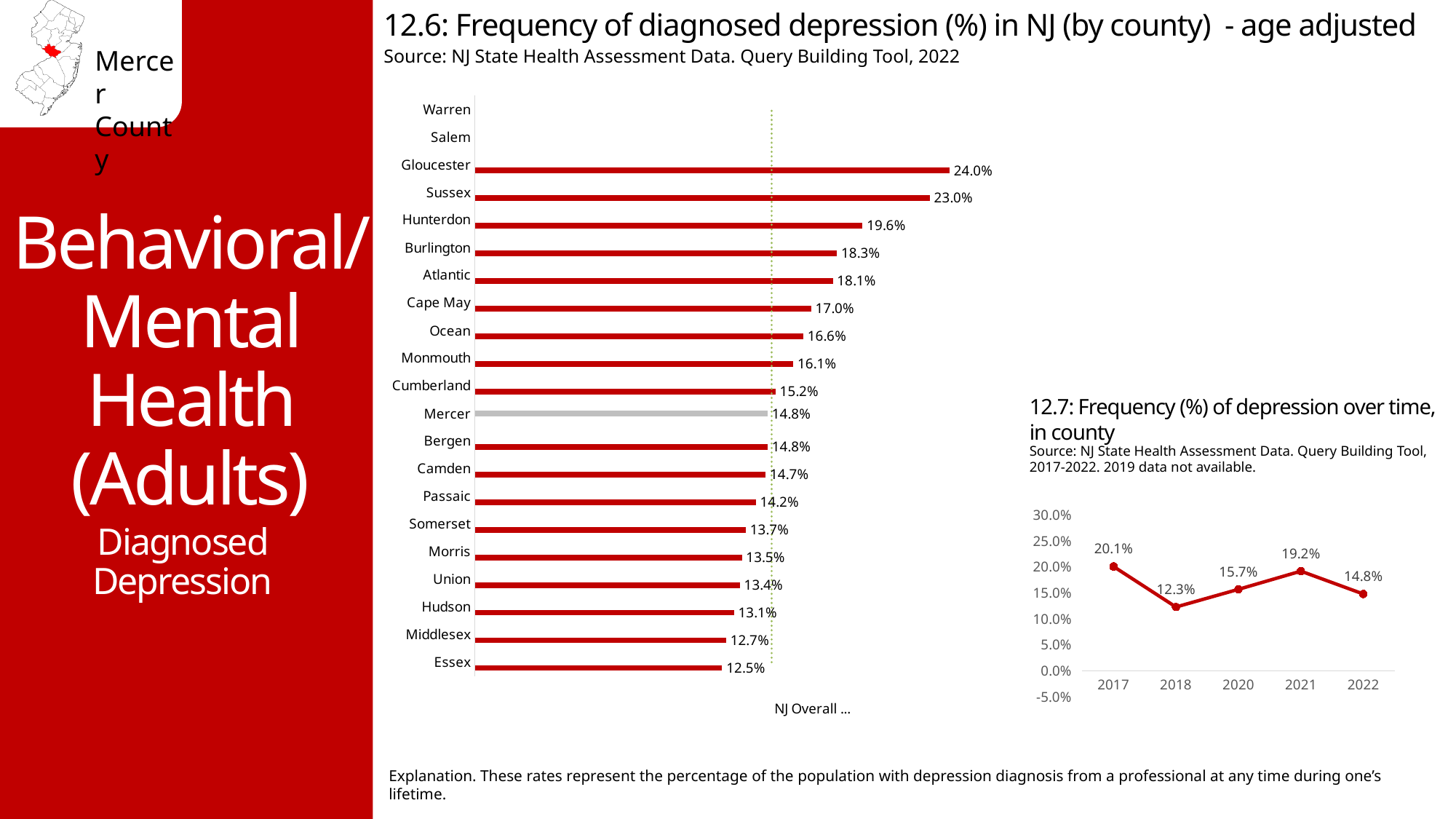
In chart 12.7, what is the difference between the values for 2021 and 2022? 4.4% In chart 12.6 (frequency of diagnosed depression by county), what is the value for Mercer? 14.8% In chart 12.6, which is larger, the value for Burlington or the value for Cape May? Burlington In chart 12.7, which year has the highest value? 2017 What kind of chart is chart 12.7? Line chart In chart 12.7 (frequency of depression over time), what is the value for 2018? 12.3% In chart 12.6, which county has the highest frequency of diagnosed depression? Gloucester What kind of chart is chart 12.6? Bar chart In chart 12.7, how many data points are plotted? 5 In chart 12.6, what is the difference between the values for Gloucester and Sussex? 1.0% In chart 12.6, which county with a plotted bar has the lowest frequency of diagnosed depression? Essex In chart 12.6, what is the value for Hunterdon? 19.6%